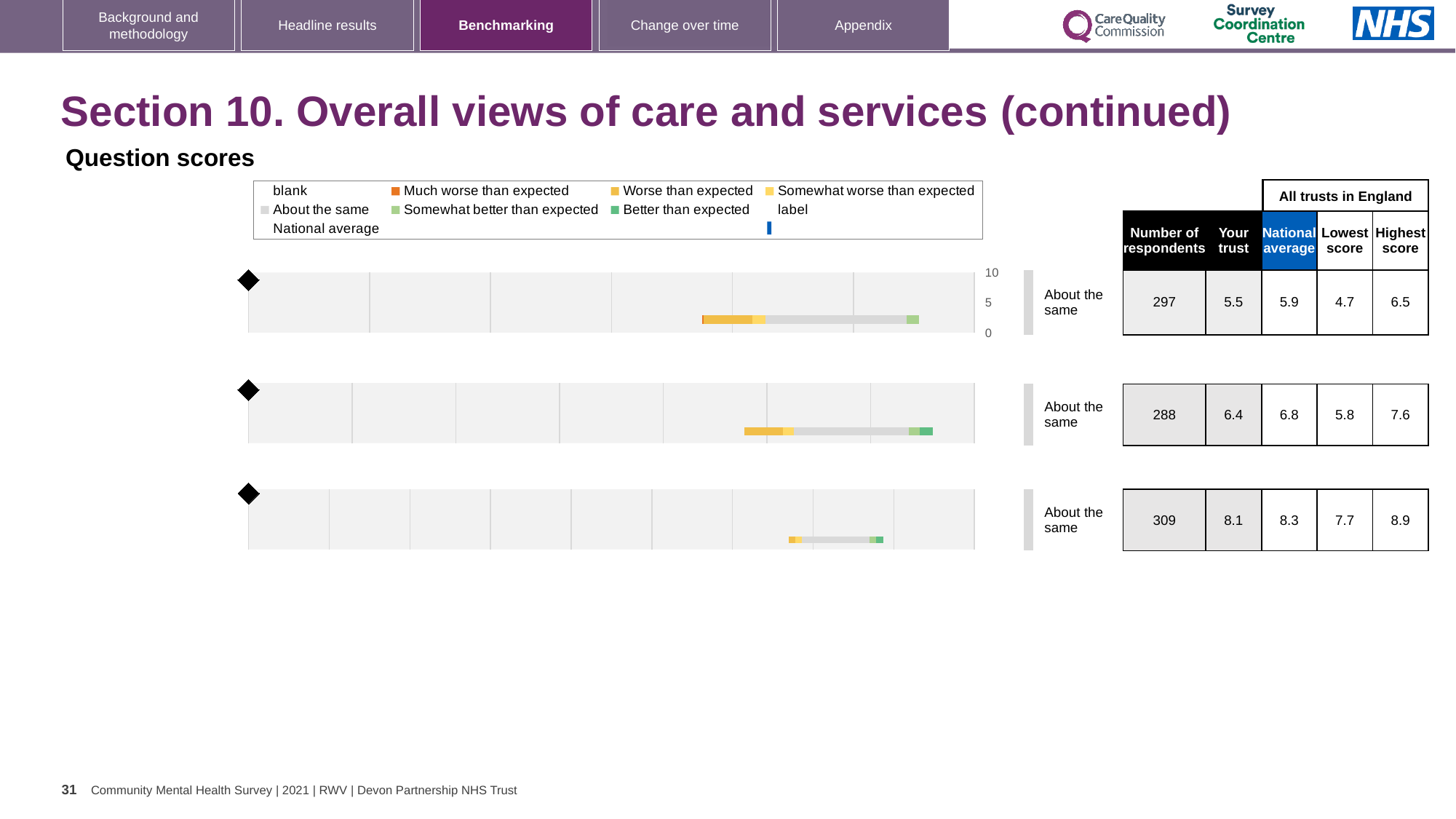
How many benchmarking charts are shown on the slide? 3 What benchmark category is shown next to the middle chart? About the same In the legend, what colour represents 'Much worse than expected'? orange For the top chart, what is the national average shown in the table beside it? 5.9 For the top chart, which is larger: the 'Your trust' score or the national average? National average For the bottom chart, what is the difference between the highest score and the lowest score shown in the table beside it? 1.2 For the bottom chart, what is the highest score across all trusts in England shown in the table beside it? 8.9 For the top chart, what is the 'Your trust' score shown in the table beside it? 5.5 What is the maximum value shown on the scale of the top chart? 10 Which of the three charts has the highest 'Your trust' score in its table? the bottom chart For the middle chart, what is the number of respondents shown in the table beside it? 288 What kind of chart is used for the three benchmarking charts on the slide? bar chart